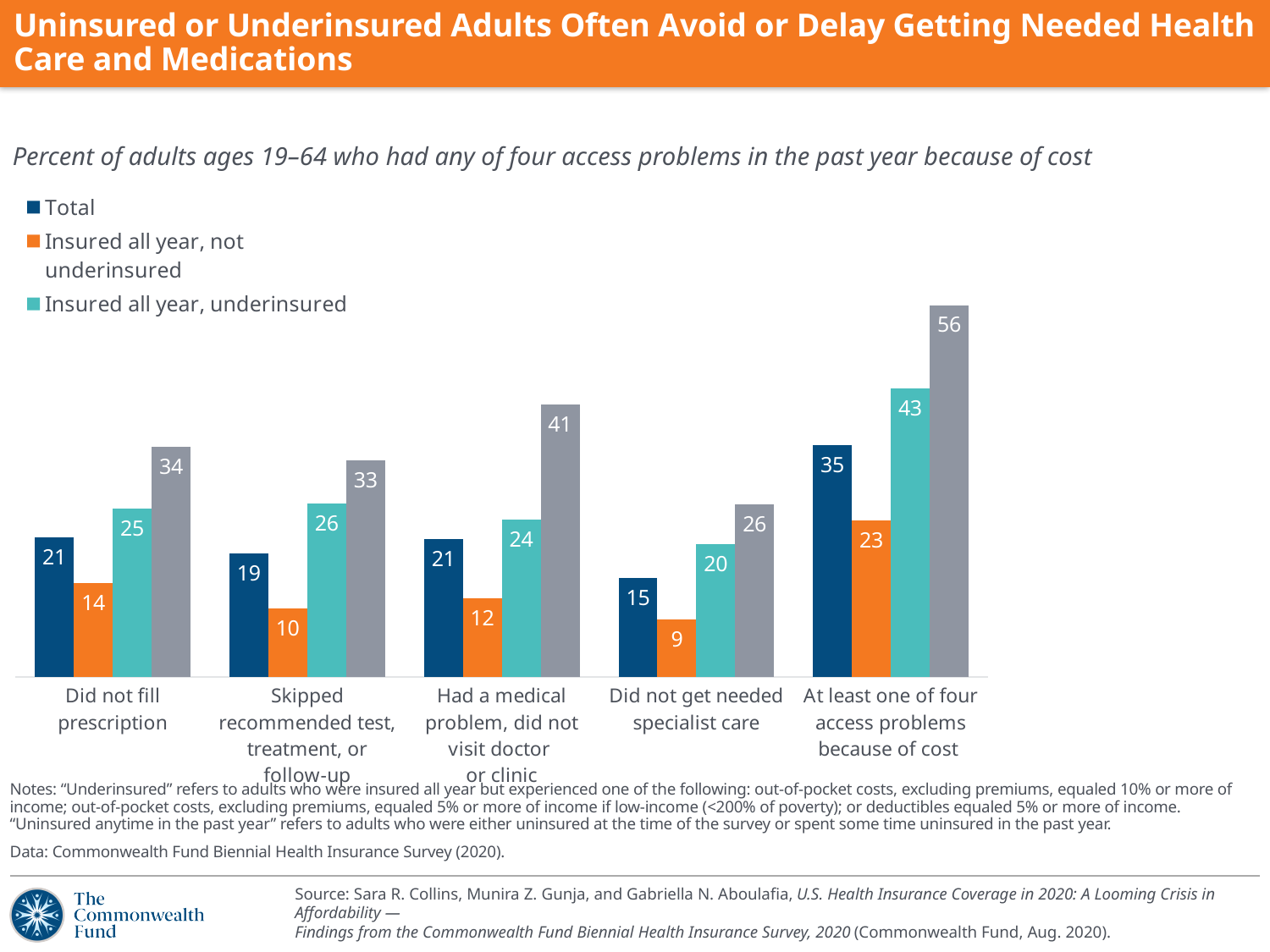
For "Had a medical problem, did not visit doctor or clinic", which is larger: the Total value or the "Insured all year, underinsured" value? Insured all year, underinsured What is the difference between the Total values for "At least one of four access problems because of cost" and "Did not fill prescription"? 14 Which category has the lowest value for "Insured all year, not underinsured"? Did not get needed specialist care What colour are the bars for the "Insured all year, not underinsured" series? Orange Which category has the highest Total value? At least one of four access problems because of cost How many categories are shown on the x axis? 5 What is the difference between the "Insured all year, underinsured" and "Insured all year, not underinsured" values for "Did not fill prescription"? 11 What kind of chart is shown on the slide? Bar chart What is the value for "Insured all year, underinsured" adults in the "At least one of four access problems because of cost" category? 43 What is the Total value for "Did not get needed specialist care"? 15 How many series does the legend list? 3 What is the value for "Insured all year, not underinsured" adults who skipped recommended test, treatment, or follow-up? 10